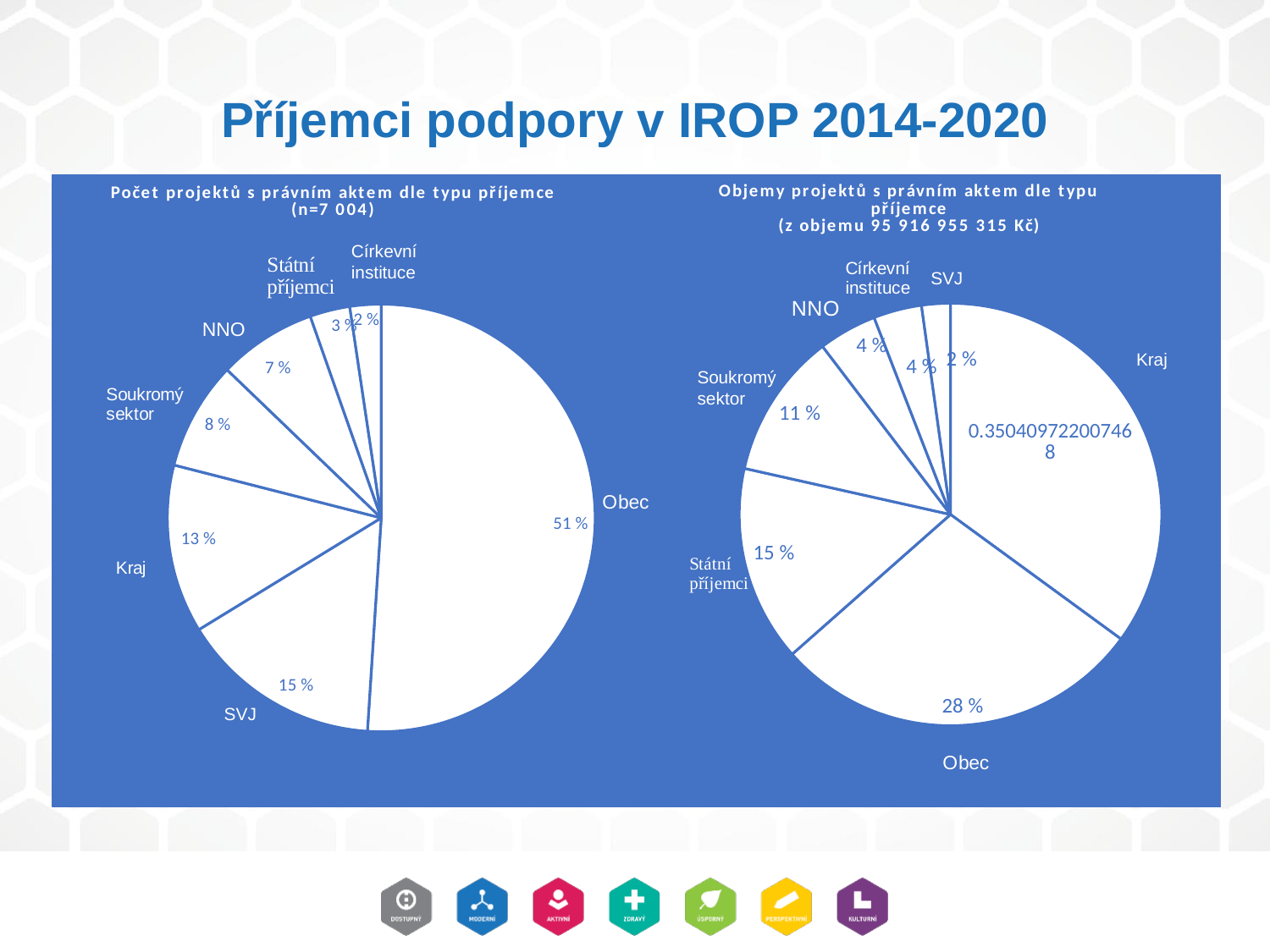
In the left pie chart (Počet projektů s právním aktem dle typu příjemce), what is the difference between the shares of SVJ and Soukromý sektor? 7 % In the right pie chart (Objemy projektů s právním aktem dle typu příjemce), what share is labelled for Obec? 28 % In the left pie chart (Počet projektů s právním aktem dle typu příjemce), which category has the largest slice? Obec What type of chart is used on this slide? Pie chart What total volume in Kč is stated in the title of the right pie chart? 95 916 955 315 Kč In the left pie chart (Počet projektů s právním aktem dle typu příjemce), which category has the smallest slice? Církevní instituce In the left pie chart (Počet projektů s právním aktem dle typu příjemce), what share is labelled for Kraj? 13 % In the left pie chart (Počet projektů s právním aktem dle typu příjemce), what share is labelled for Obec? 51 % In the right pie chart (Objemy projektů s právním aktem dle typu příjemce), which category has the largest slice? Kraj In the left pie chart (Počet projektů s právním aktem dle typu příjemce), how many categories are shown? 7 In the right pie chart (Objemy projektů s právním aktem dle typu příjemce), what share is labelled for Státní příjemci? 15 % In the right pie chart (Objemy projektů s právním aktem dle typu příjemce), which is larger, the share of Soukromý sektor or the share of NNO? Soukromý sektor